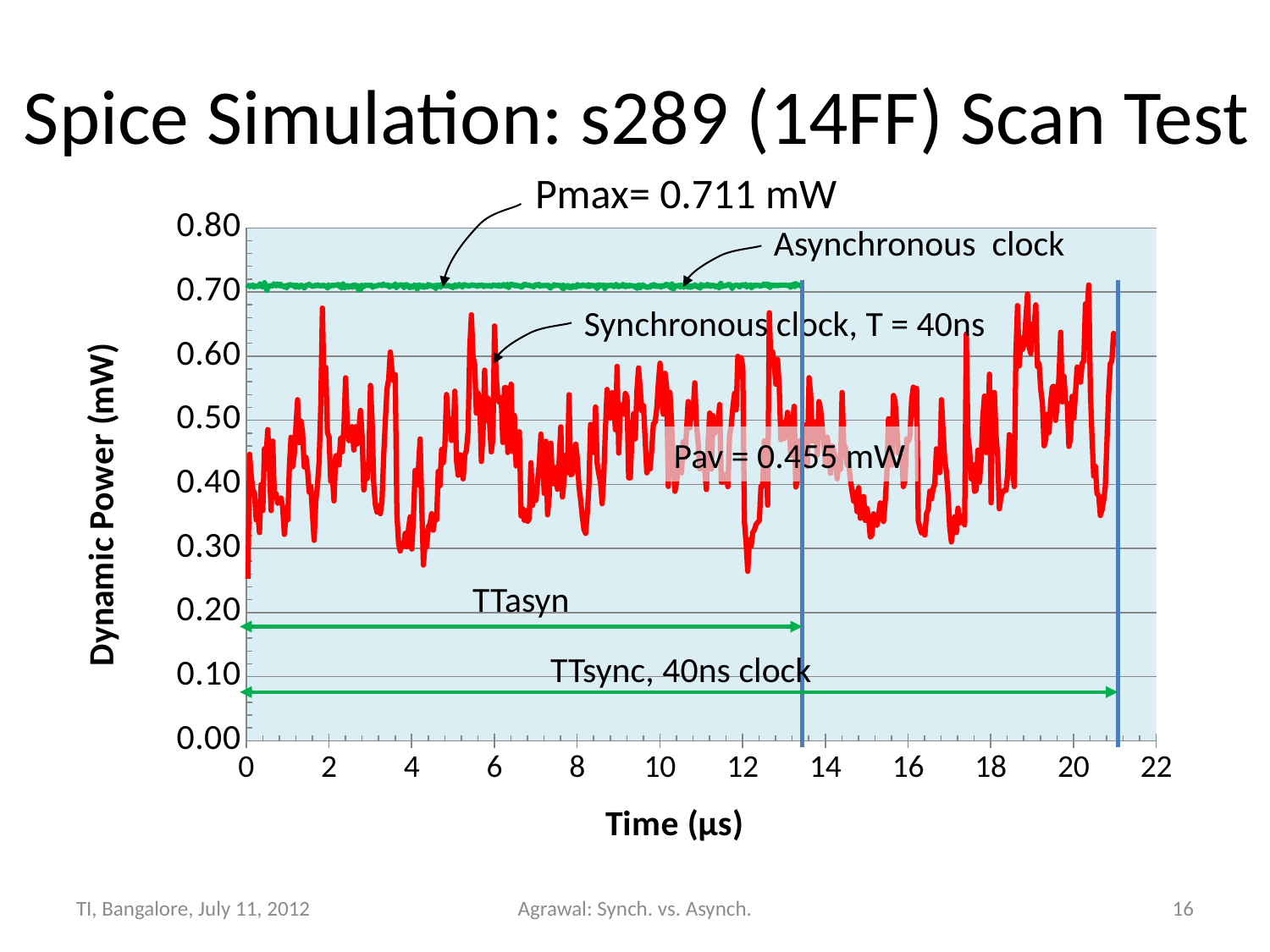
How many series are plotted on the chart? 2 Which series shows the higher dynamic power, the asynchronous clock or the synchronous clock? Asynchronous clock What is the clock period T given for the synchronous clock? 40ns Does the asynchronous clock trace end before or after 14 µs? before What kind of chart is shown on the slide? line chart What is the label of the x axis? Time (µs) What is the label of the y axis? Dynamic Power (mW) Which test takes longer in time, TTasyn or TTsync? TTsync Is the dynamic power of the asynchronous clock greater or less than 0.60 mW? greater What is the value of Pmax annotated on the chart? 0.711 mW What is the value of Pav annotated on the chart? 0.455 mW